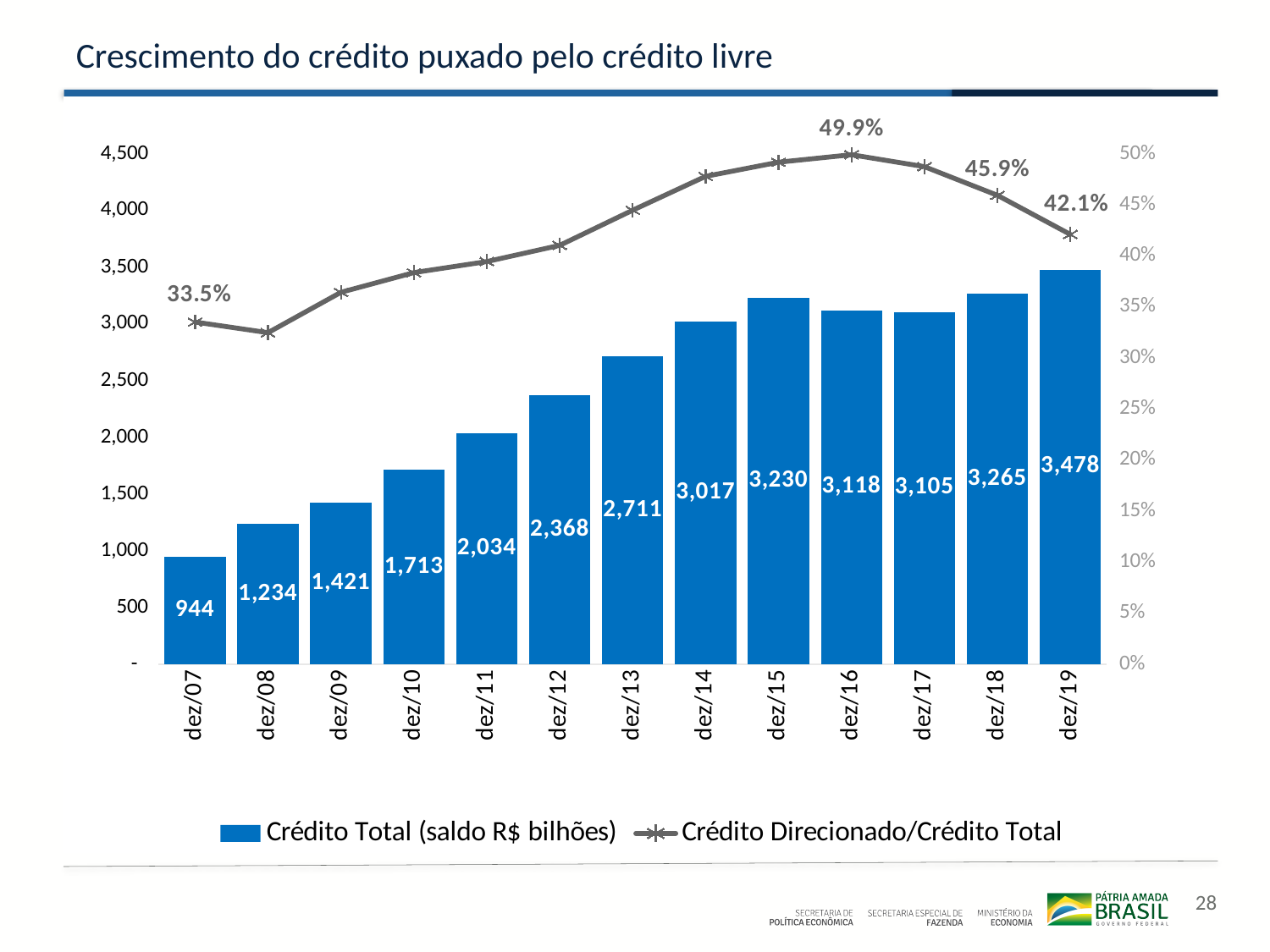
What is the difference in Crédito Total (saldo R$ bilhões) between dez/19 and dez/18? 213 Which period has the lowest Crédito Total (saldo R$ bilhões)? dez/07 Is the Crédito Direcionado/Crédito Total ratio for dez/13 greater or less than 40%? greater What is the Crédito Direcionado/Crédito Total ratio shown for dez/16? 49.9% How many periods are shown on the x axis of the chart? 13 What is the value of Crédito Total (saldo R$ bilhões) for dez/07? 944 Which period has the highest Crédito Total (saldo R$ bilhões)? dez/19 What is the title of the slide containing the chart? Crescimento do crédito puxado pelo crédito livre Which is larger, the Crédito Total for dez/15 or for dez/16? dez/15 What is the Crédito Direcionado/Crédito Total ratio shown for dez/18? 45.9% What is the value of Crédito Total (saldo R$ bilhões) for dez/19? 3,478 How many series does the legend list? 2